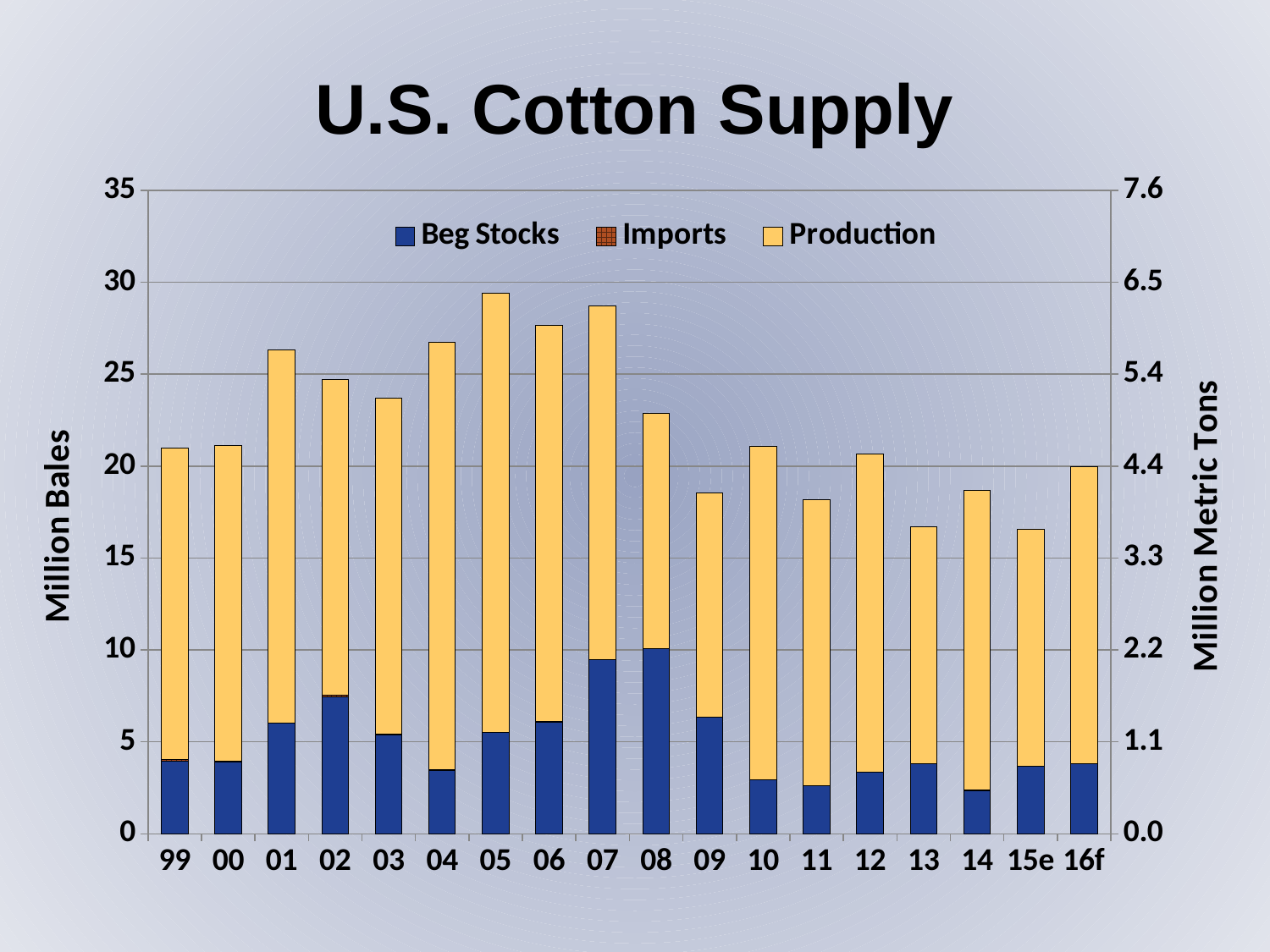
Which year has the larger total supply bar, 01 or 03? 01 Which year has the tallest total supply bar? 05 How many years (categories) are shown along the x axis? 18 Do the total supply bars rise or fall from 07 to 09? fall How many series does the legend list? 3 Is the Beg Stocks value for 07 greater or less than 5 million bales? greater Which year has the largest Beg Stocks segment? 08 What is the title of the right vertical axis? Million Metric Tons Is the total supply for 13 greater or less than 20 million bales? less What is the title of the left vertical axis? Million Bales What kind of chart is shown on the slide? Stacked bar chart Is the total supply for 05 greater or less than 25 million bales? greater